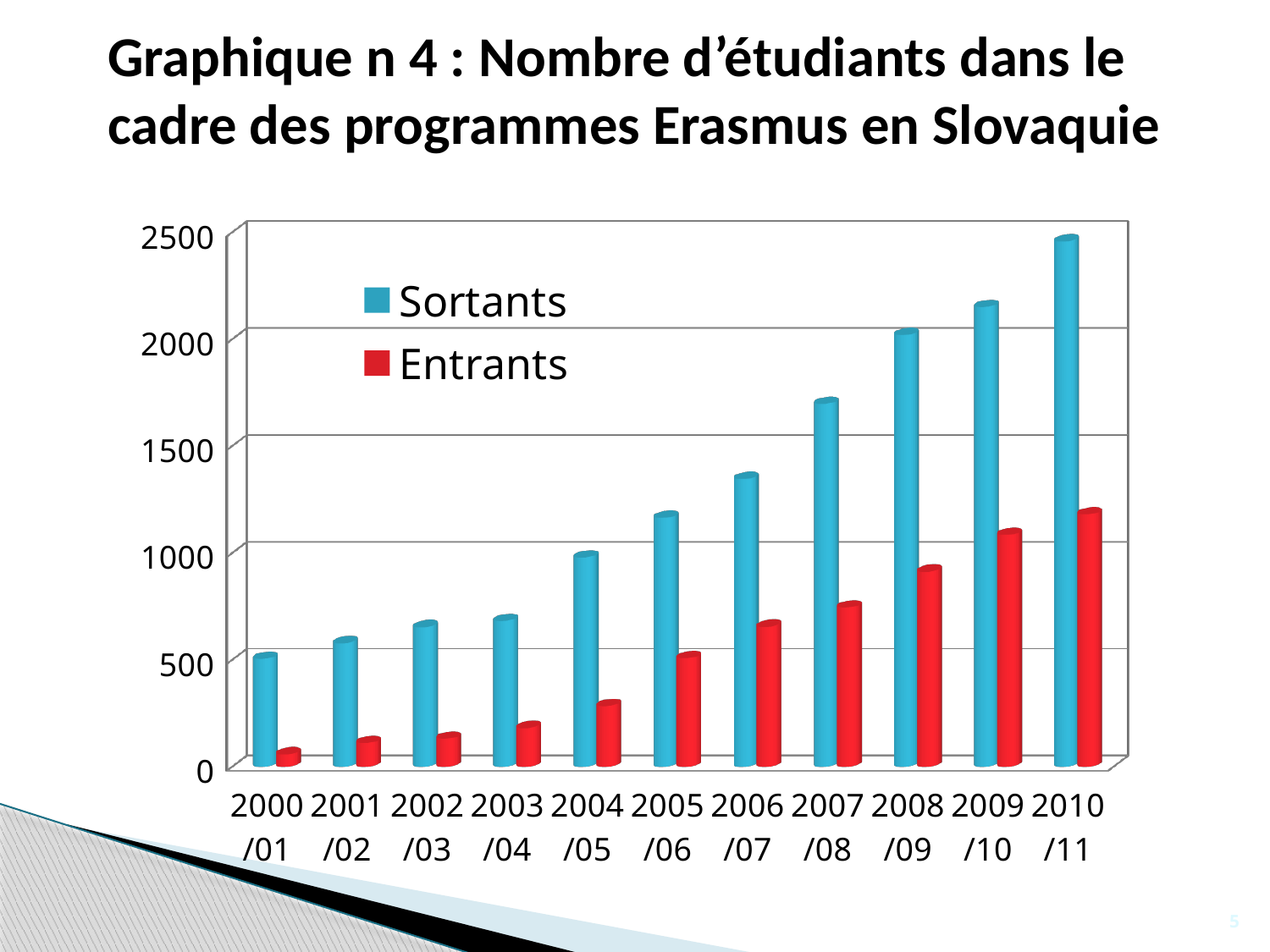
Is the value for Sortants in 2006/07 greater or less than 1500? less Which academic year has the lowest value for Entrants? 2000/01 In 2010/11, which series has the larger value, Sortants or Entrants? Sortants Is the value for Sortants in 2010/11 greater or less than 2000? greater Which colour represents the Entrants series? red How many series does the legend list? 2 Is the value for Entrants in 2010/11 greater or less than 1000? greater Do the Sortants values rise or fall from 2000/01 to 2010/11? rise How many academic years are shown on the x axis? 11 What kind of chart is shown on the slide? bar chart Which academic year has the highest value for Sortants? 2010/11